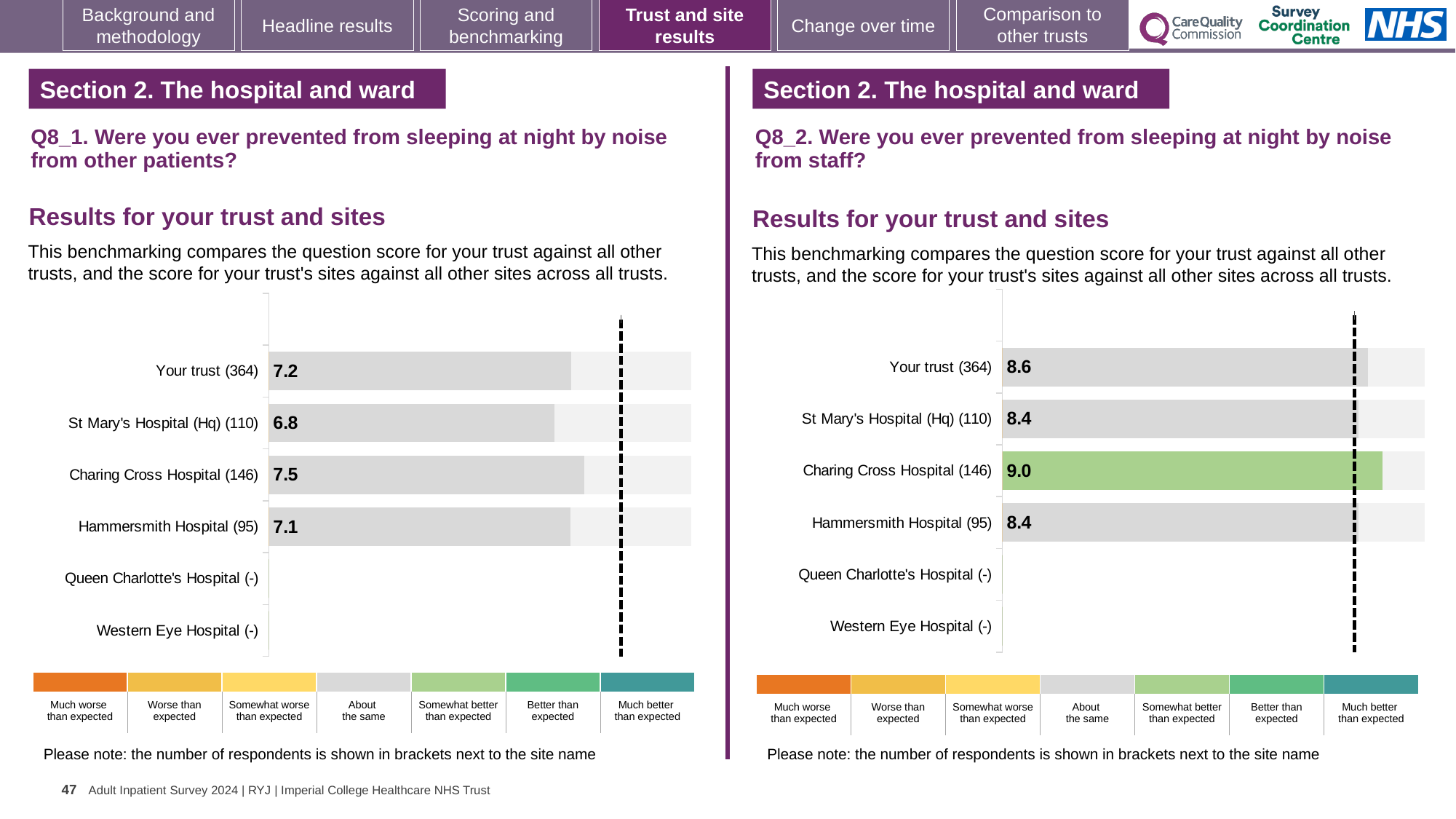
In the Q8_1 chart (noise from other patients), what is the difference between the scores for Charing Cross Hospital (146) and Hammersmith Hospital (95)? 0.4 In the Q8_2 chart (noise from staff), which site has the highest score? Charing Cross Hospital (146) In the Q8_1 chart (noise from other patients), what is the score for St Mary's Hospital (Hq) (110)? 6.8 In the Q8_2 chart (noise from staff), what is the score for Charing Cross Hospital (146)? 9.0 In the Q8_1 chart (noise from other patients), which site has the highest score? Charing Cross Hospital (146) How many site labels are listed on the y axis of the Q8_1 chart (noise from other patients)? 6 In the Q8_1 chart (noise from other patients), what is the score for Your trust (364)? 7.2 In the Q8_1 chart (noise from other patients), which site has the lowest score? St Mary's Hospital (Hq) (110) In the Q8_2 chart (noise from staff), which is larger: the score for Your trust (364) or for St Mary's Hospital (Hq) (110)? Your trust (364) In the Q8_2 chart (noise from staff), what is the difference between the scores for Charing Cross Hospital (146) and Your trust (364)? 0.4 In the Q8_2 chart (noise from staff), what is the score for Hammersmith Hospital (95)? 8.4 What kind of chart is used for the Q8_2 results (noise from staff)? Bar chart